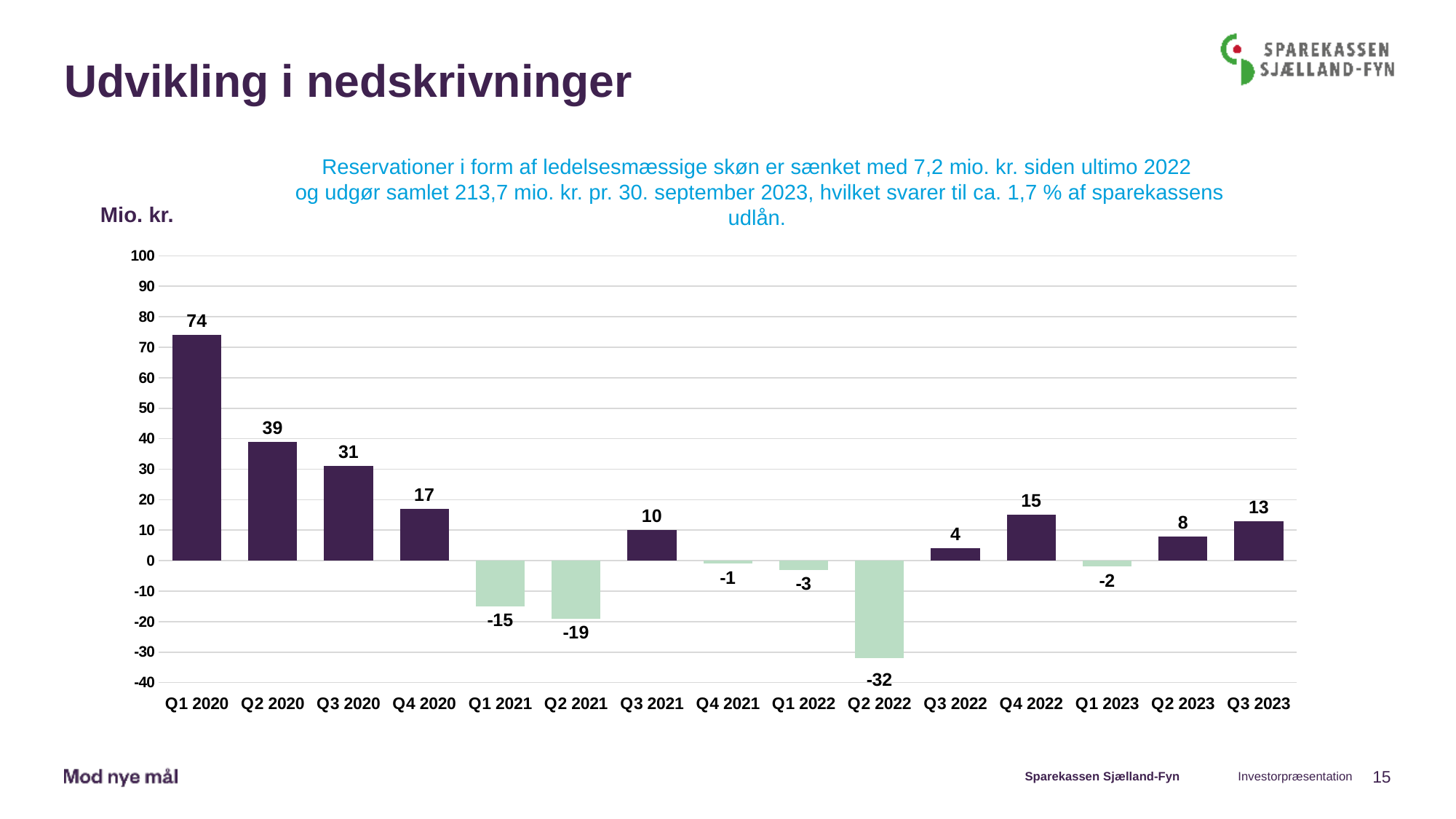
What unit is shown above the y axis? Mio. kr. What is the difference between the values for Q1 2020 and Q2 2020? 35 What is the value for Q2 2022? -32 Do the values rise or fall from Q1 2020 to Q4 2020? Fall Which quarter has the highest value? Q1 2020 Which is larger, the value for Q4 2022 or the value for Q2 2023? Q4 2022 What kind of chart is shown on the slide? Bar chart What is the value for Q3 2023? 13 What is the value for Q2 2021? -19 How many quarters are shown on the x axis? 15 Which quarter has the lowest value? Q2 2022 What is the value for Q1 2020? 74